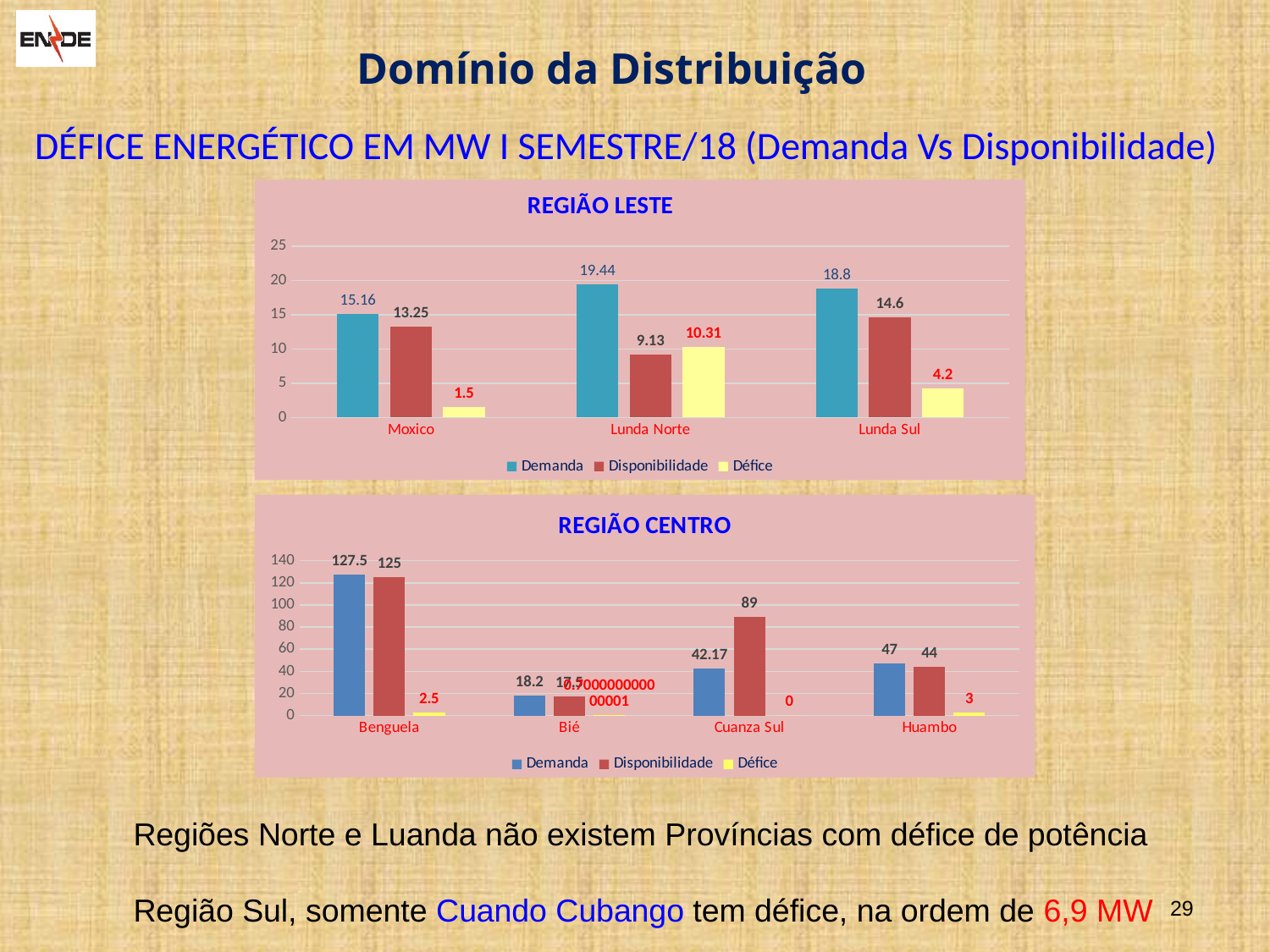
In the REGIÃO LESTE chart, what is the difference between Demanda and Disponibilidade for Moxico? 1.91 In the REGIÃO LESTE chart, what is the Demanda value for Lunda Norte? 19.44 In the REGIÃO LESTE chart, how many series does the legend list? 3 In the REGIÃO LESTE chart, what is the Défice value for Lunda Sul? 4.2 In the REGIÃO CENTRO chart, how many provinces are shown on the x axis? 4 In the REGIÃO LESTE chart, which province has the highest Défice? Lunda Norte In the REGIÃO LESTE chart, which province has the lowest Disponibilidade? Lunda Norte What type of chart is the REGIÃO CENTRO chart? Bar chart In the REGIÃO CENTRO chart, is Demanda or Disponibilidade larger for Cuanza Sul? Disponibilidade In the REGIÃO CENTRO chart, which province has the highest Demanda? Benguela In the REGIÃO CENTRO chart, what is the Défice value for Huambo? 3 In the REGIÃO CENTRO chart, what is the Disponibilidade value for Cuanza Sul? 89